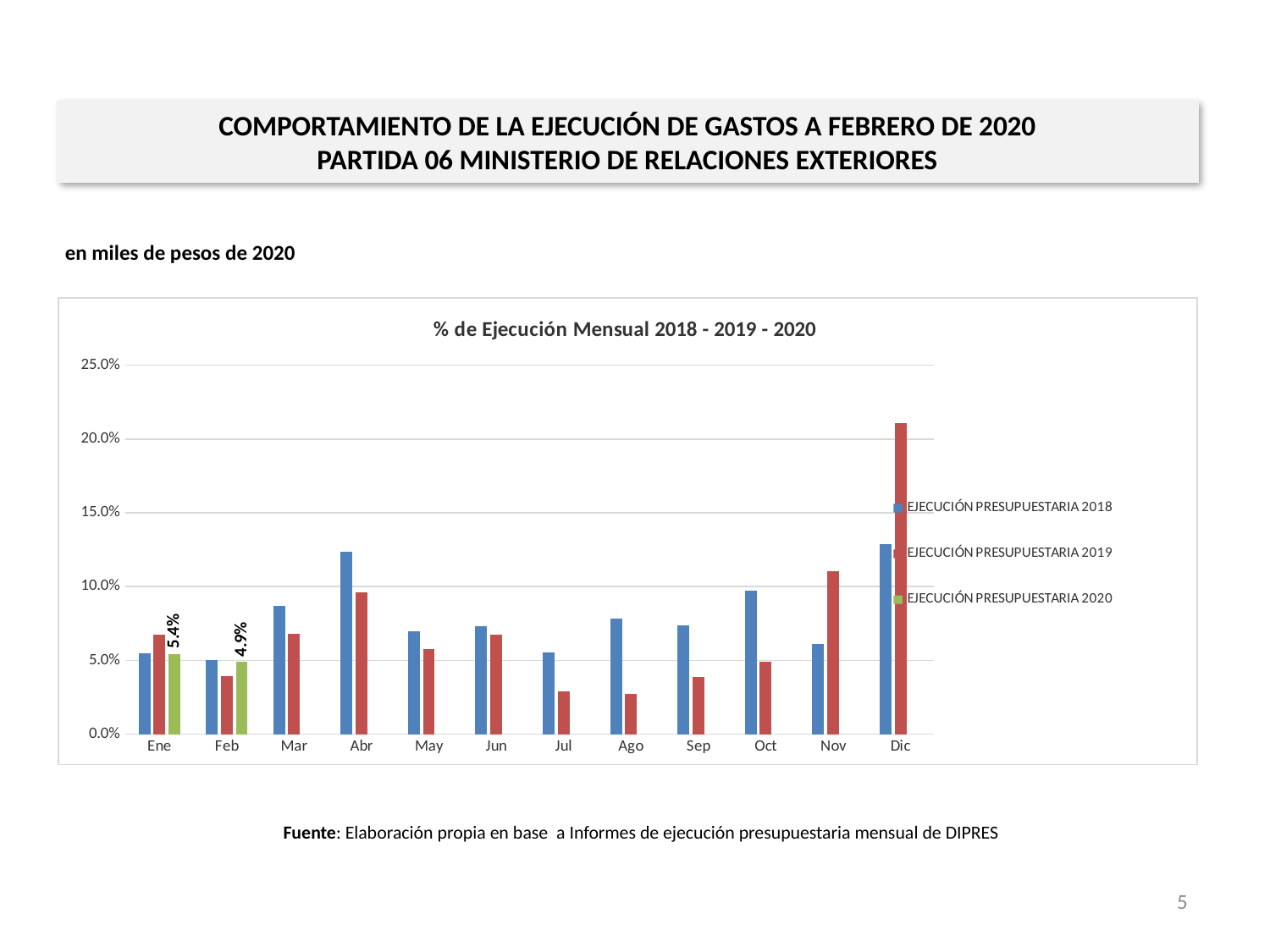
Is the EJECUCIÓN PRESUPUESTARIA 2019 value for Jul greater or less than 5.0%? less How many months are shown on the x axis of the chart? 12 What type of chart is shown on the slide? Bar chart Is the EJECUCIÓN PRESUPUESTARIA 2019 value for Dic greater or less than 20.0%? greater What is the difference between the EJECUCIÓN PRESUPUESTARIA 2020 values for Ene and Feb? 0.5% In Nov, which series has the larger value, EJECUCIÓN PRESUPUESTARIA 2018 or EJECUCIÓN PRESUPUESTARIA 2019? EJECUCIÓN PRESUPUESTARIA 2019 In which month is the EJECUCIÓN PRESUPUESTARIA 2019 value highest? Dic What is the value for EJECUCIÓN PRESUPUESTARIA 2020 in Ene? 5.4% What is the value for EJECUCIÓN PRESUPUESTARIA 2020 in Feb? 4.9% How many series does the chart legend list? 3 Is the EJECUCIÓN PRESUPUESTARIA 2018 value for Abr greater or less than 10.0%? greater In Abr, which series has the larger value, EJECUCIÓN PRESUPUESTARIA 2018 or EJECUCIÓN PRESUPUESTARIA 2019? EJECUCIÓN PRESUPUESTARIA 2018